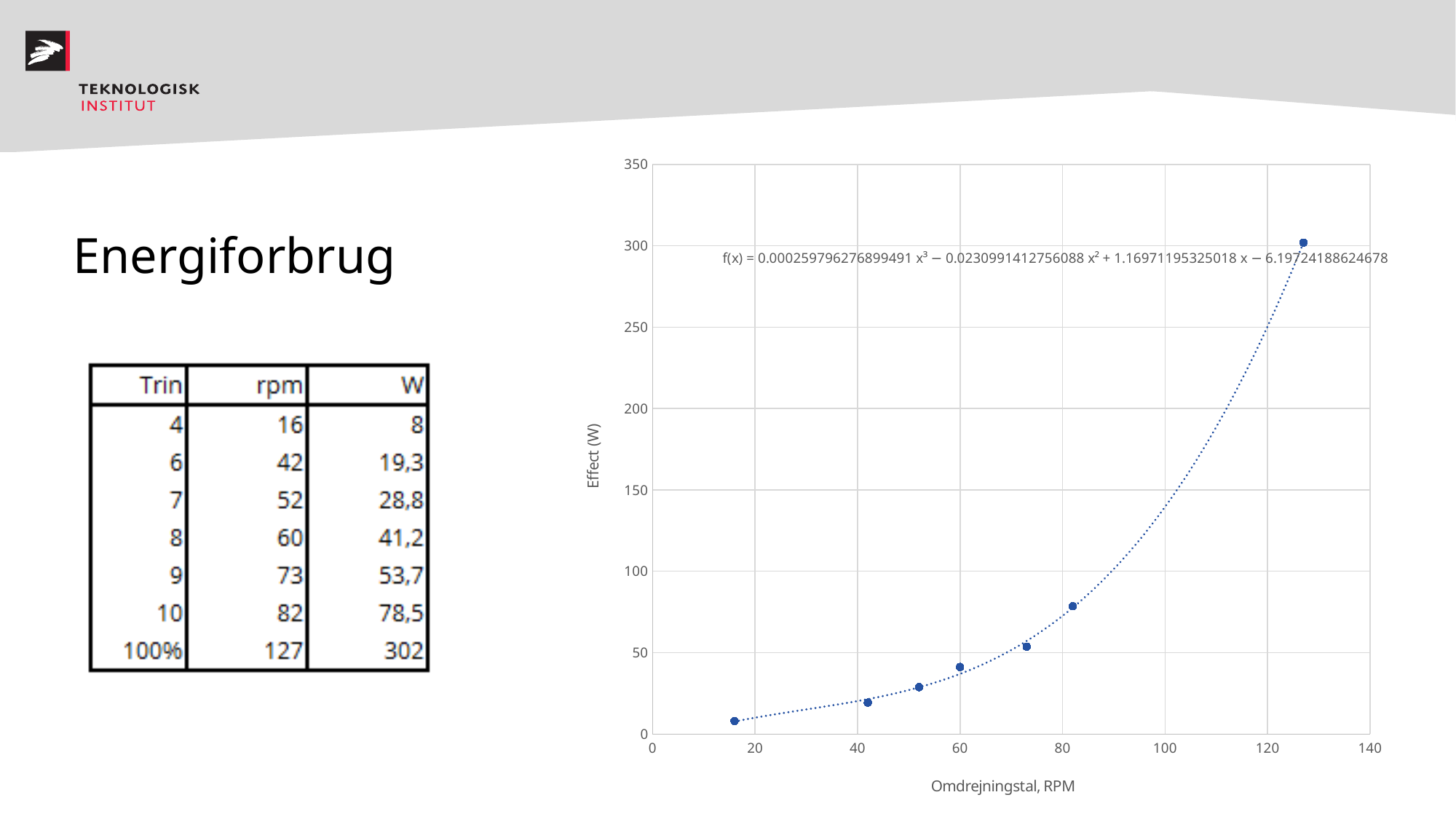
Is the plotted effect at 16 RPM greater or less than 50? less How many data points are plotted in the chart? 7 At which RPM is the plotted effect lowest? 16 Using the table values, what is the difference in W between the effect at 127 rpm and at 82 rpm? 223,5 At which RPM is the plotted effect highest? 127 Is the plotted effect at 82 RPM greater or less than 100? less Which has the higher plotted effect: 73 RPM or 52 RPM? 73 RPM Do the plotted effect values rise or fall as RPM increases along the x axis? rise What kind of chart is shown on the slide? Scatter chart What is the title of the chart's x axis? Omdrejningstal, RPM According to the table on the slide, what is the effect in W at 60 rpm? 41,2 Is the plotted effect at 127 RPM greater or less than 250? greater